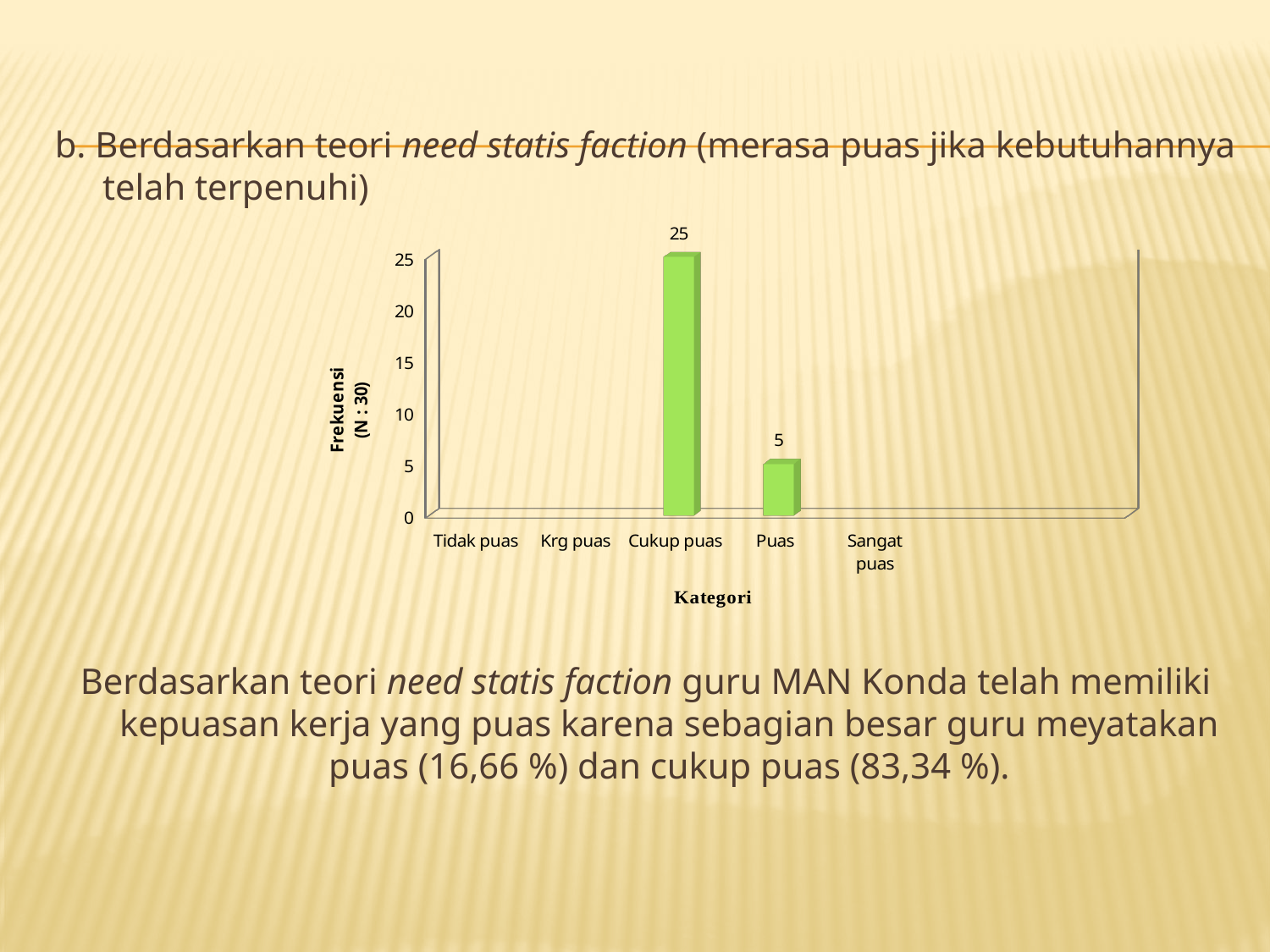
What is the label of the x axis? Kategori Which category has the highest value? Cukup puas What is the value for Cukup puas? 25 What is the difference between the values for Cukup puas and Puas? 20 What is the total of the values for Cukup puas and Puas? 30 What is the label of the y axis? Frekuensi (N : 30) How many categories are shown on the x axis? 5 Is the value for Cukup puas greater or less than 20? greater Is the value for Puas greater or less than 10? less Which is larger, the value for Cukup puas or the value for Puas? Cukup puas What is the value for Puas? 5 What kind of chart is shown? bar chart